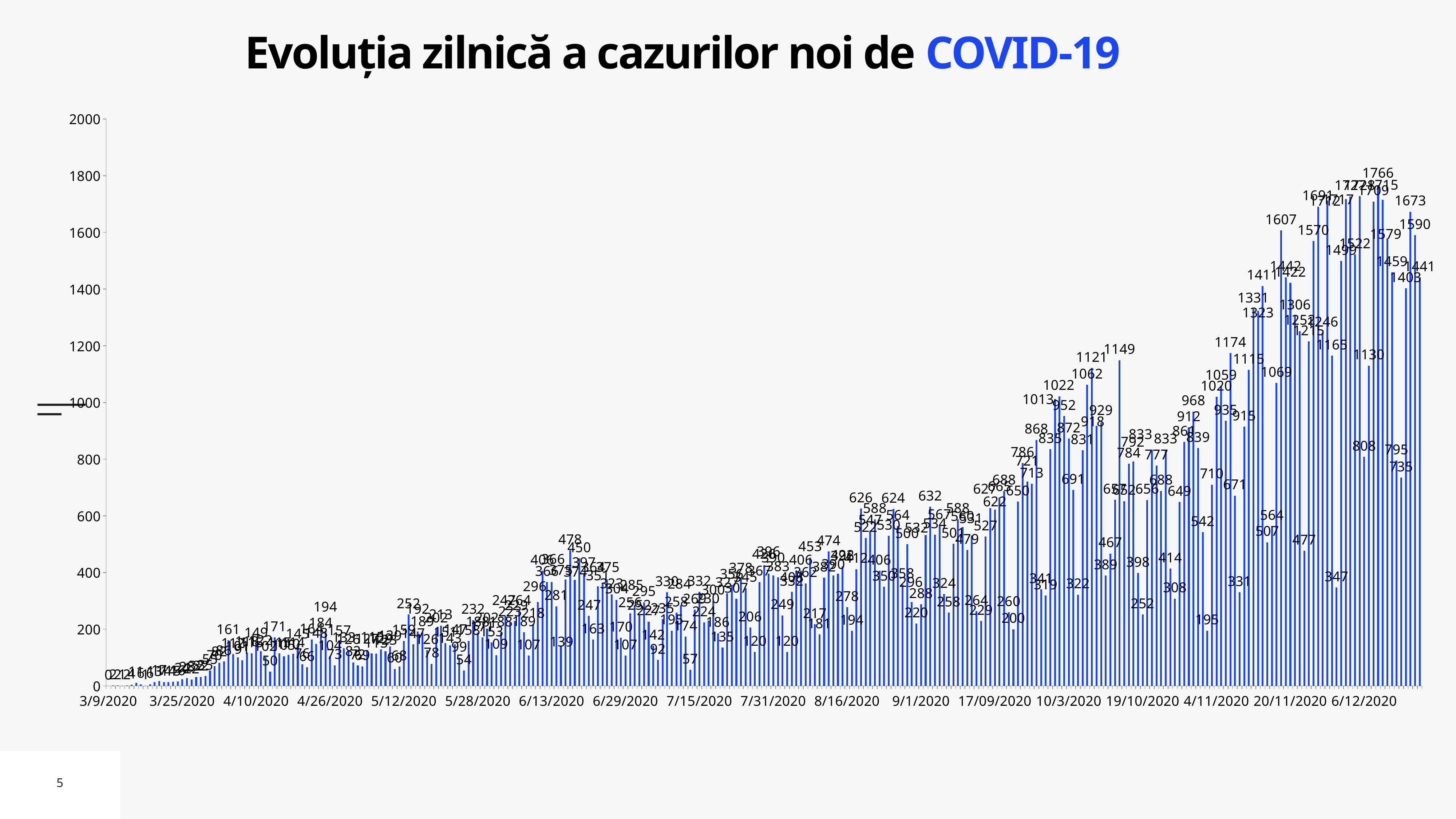
What is the last date label shown on the horizontal axis? 6/12/2020 What is the first date shown on the horizontal axis? 3/9/2020 Overall, do the daily values rise or fall from March 2020 to December 2020? rise What is the highest daily value labelled on the chart? 1766 What kind of chart is shown on the slide? bar chart Is the value for 3/9/2020 greater or less than 200? less Which period has larger daily values: late March 2020 or early December 2020? early December 2020 Is the highest value on the chart greater or less than 1800? less How many data series are plotted on the chart? 1 What is the title of the chart? Evoluția zilnică a cazurilor noi de COVID-19 What is the maximum value shown on the vertical axis? 2000